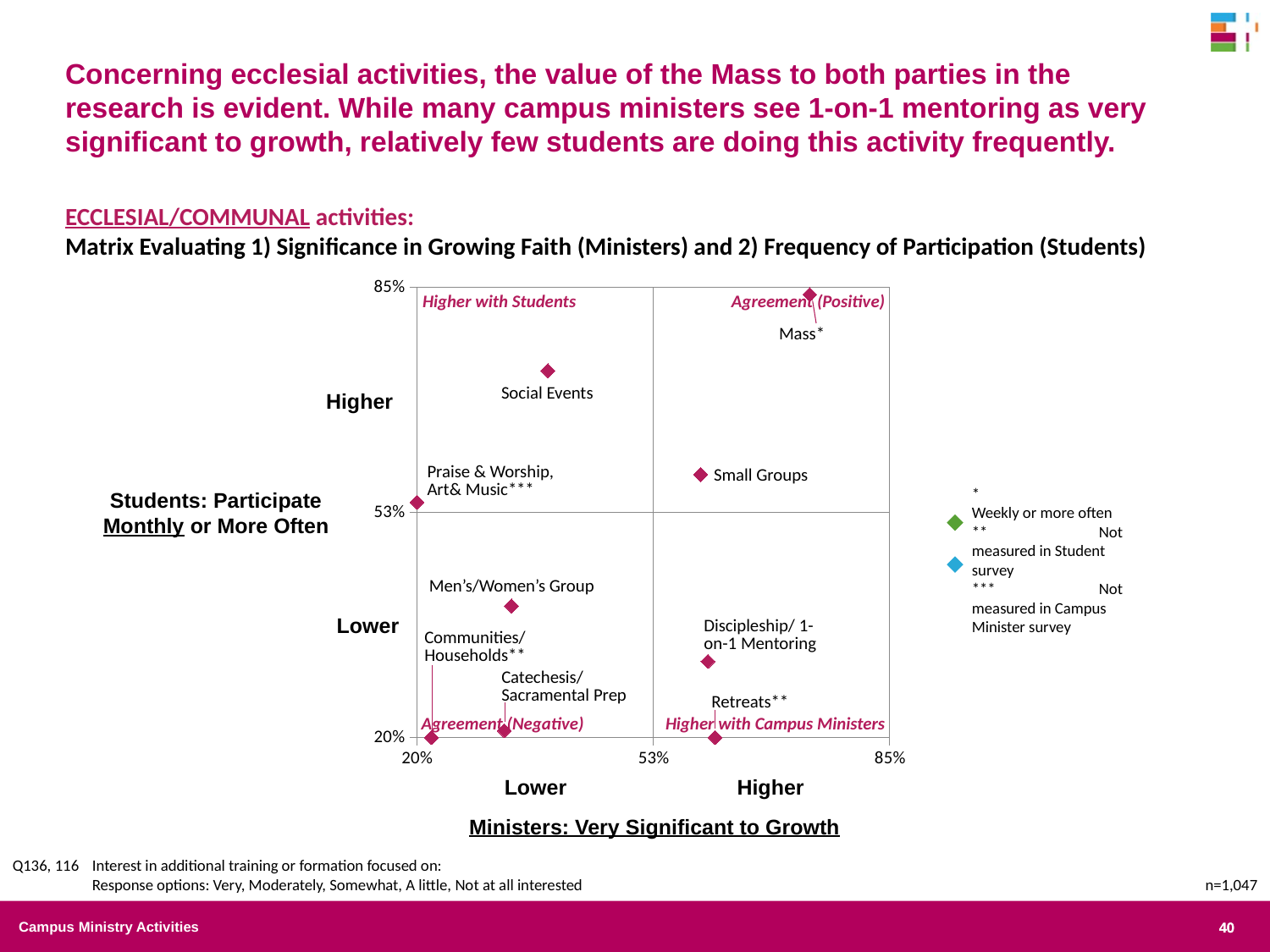
Which activity has the highest value on the horizontal axis (Ministers: Very Significant to Growth)? Mass* Is the horizontal-axis value for Small Groups greater or less than 53%? greater What label is given to the top-right quadrant of the chart? Agreement (Positive) Which has the higher horizontal-axis value, Discipleship/ 1-on-1 Mentoring or Men's/Women's Group? Discipleship/ 1-on-1 Mentoring How many activities are plotted as points on the chart? 9 Is the vertical-axis value for Discipleship/ 1-on-1 Mentoring greater or less than 53%? less Which has the higher vertical-axis value, Social Events or Small Groups? Social Events Is the horizontal-axis value for Men's/Women's Group greater or less than 53%? less What is the title of the horizontal axis of the chart? Ministers: Very Significant to Growth What kind of chart is shown on the slide? Scatter plot Which activity has the highest value on the vertical axis (Students: Participate Monthly or More Often)? Mass*